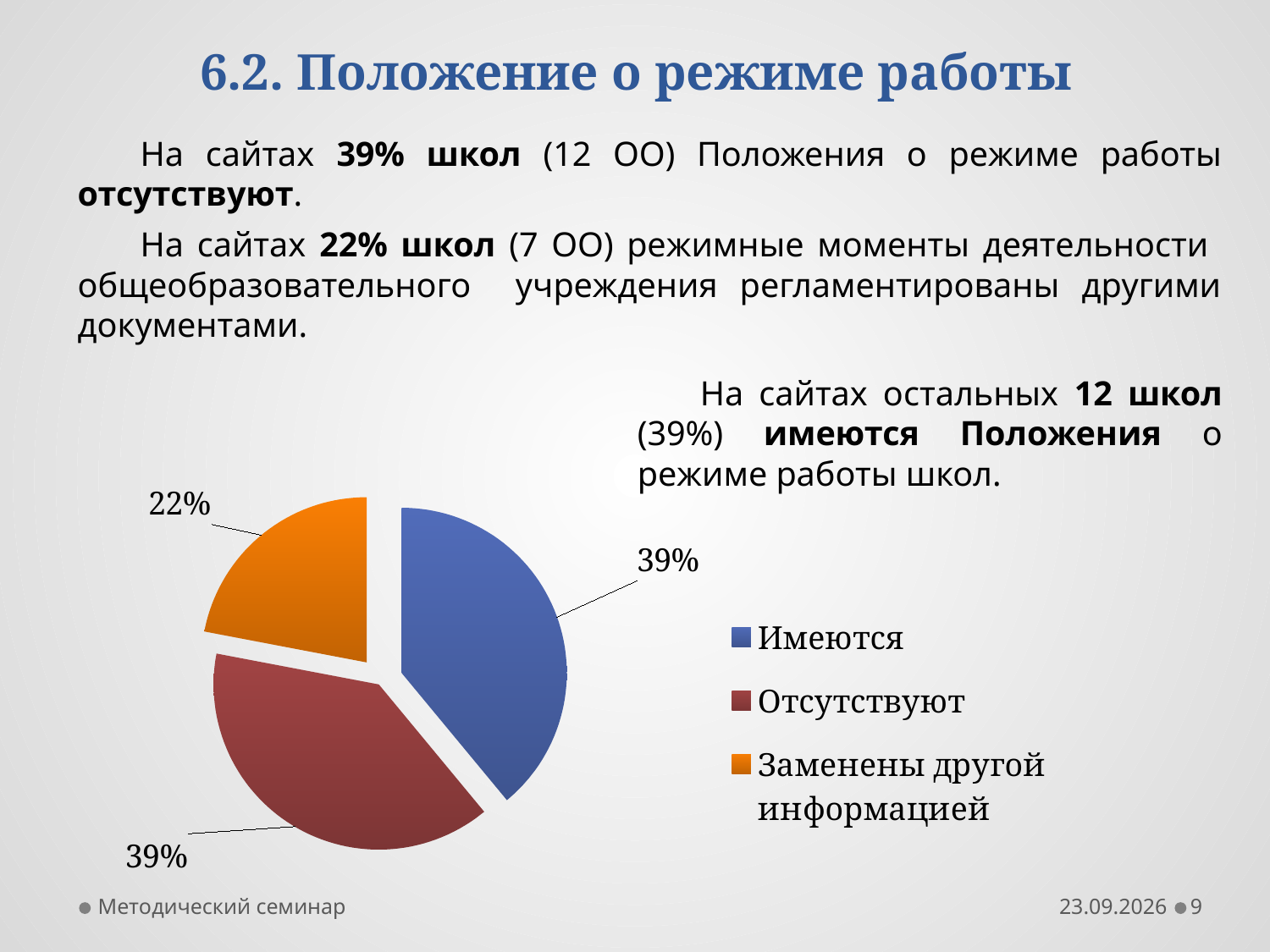
How many slices does the pie chart have? 3 What percentage does the "Отсутствуют" slice of the pie chart show? 39% What percentage does the "Имеются" slice of the pie chart show? 39% What colour is the "Заменены другой информацией" slice in the pie chart? orange What percentage does the "Заменены другой информацией" slice of the pie chart show? 22% Which category has the smallest slice in the pie chart? Заменены другой информацией How many entries does the legend of the pie chart list? 3 What colour is the "Имеются" slice in the pie chart? blue By how many percentage points does the "Отсутствуют" slice exceed the "Заменены другой информацией" slice? 17 What share of the pie does the "Заменены другой информацией" slice represent? 22% What kind of chart is shown on the slide? pie chart Which slice is larger in the pie chart: "Имеются" or "Заменены другой информацией"? Имеются